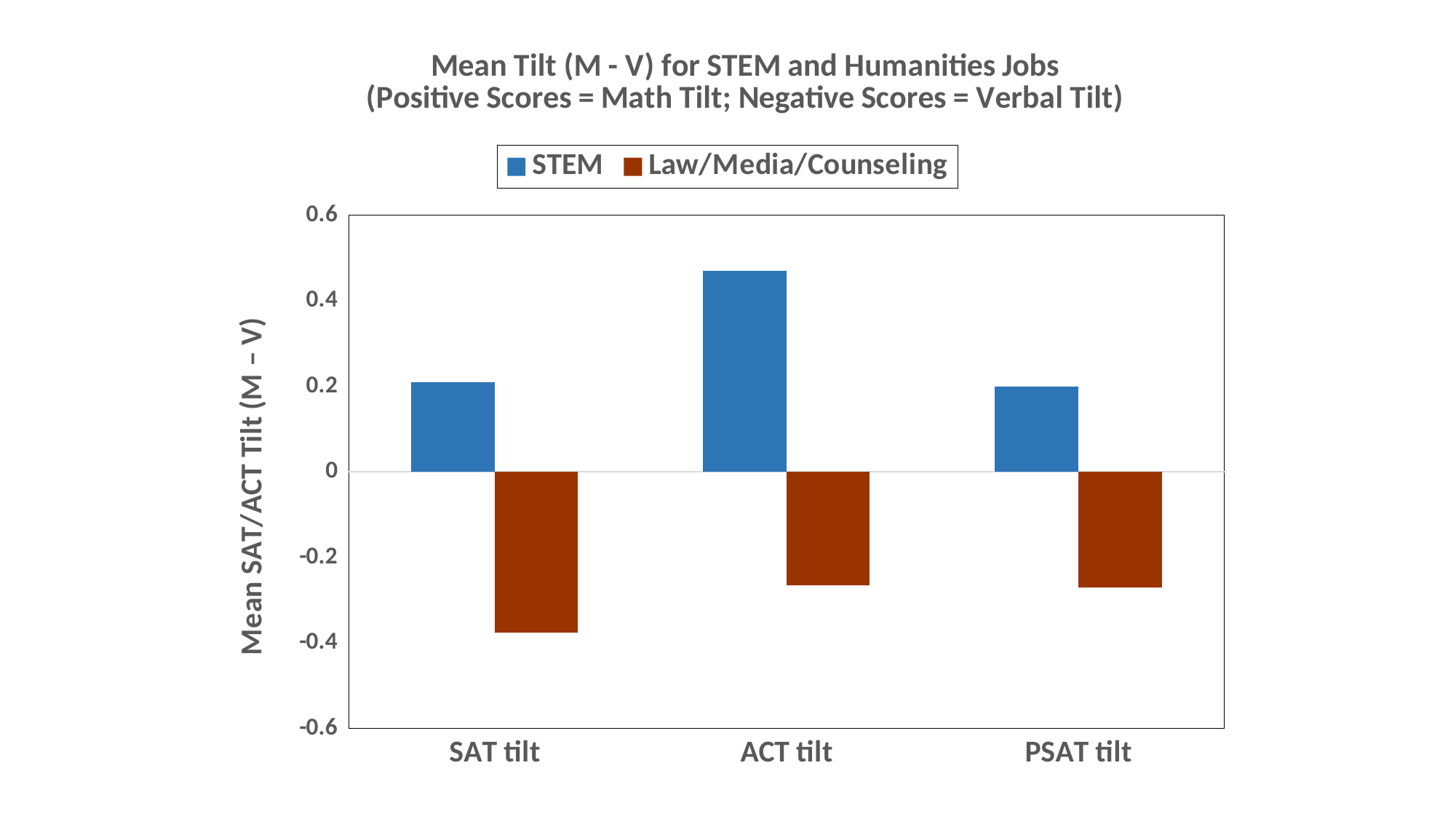
Is the STEM value for SAT tilt greater or less than 0.4? less Which series is shown in blue? STEM Is the Law/Media/Counseling value for SAT tilt greater or less than -0.2? less What is the label of the y axis? Mean SAT/ACT Tilt (M – V) Is the Law/Media/Counseling value for ACT tilt greater or less than -0.4? greater Which is larger, the STEM value for ACT tilt or the STEM value for SAT tilt? ACT tilt Which category has the lowest Law/Media/Counseling value? SAT tilt What kind of chart is shown on the slide? bar chart How many series does the legend list? 2 Which category has the highest STEM value? ACT tilt How many categories are shown on the x axis? 3